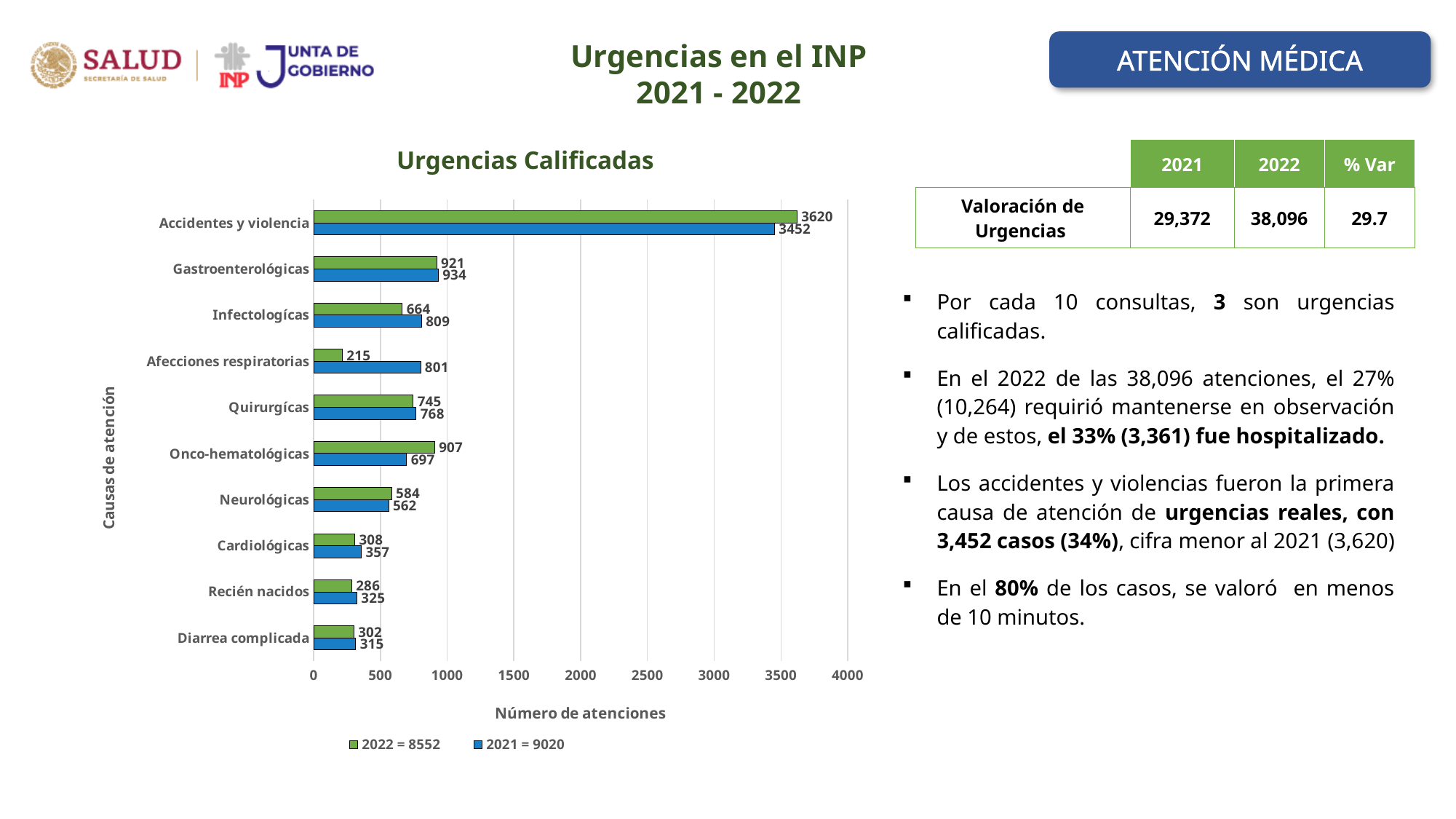
Which cause of attention has the highest number of atenciones in the chart? Accidentes y violencia What is the value for Infectologícas in the 2021 series? 809 How many causes of attention (categories) are listed on the y axis of the chart? 10 What is the label of the x axis of the chart? Número de atenciones How many series does the chart legend list? 2 What kind of chart is shown under the title "Urgencias Calificadas"? Bar chart For Onco-hematológicas, which series has the larger value, 2022 or 2021? 2022 What is the value for Onco-hematológicas in the 2022 series? 907 What is the value for Afecciones respiratorias in the 2022 series? 215 Which cause of attention has the lowest value in the 2022 series? Afecciones respiratorias What is the difference between the 2021 and 2022 values for Afecciones respiratorias? 586 Is the 2021 value for Gastroenterológicas greater or less than 1000? less